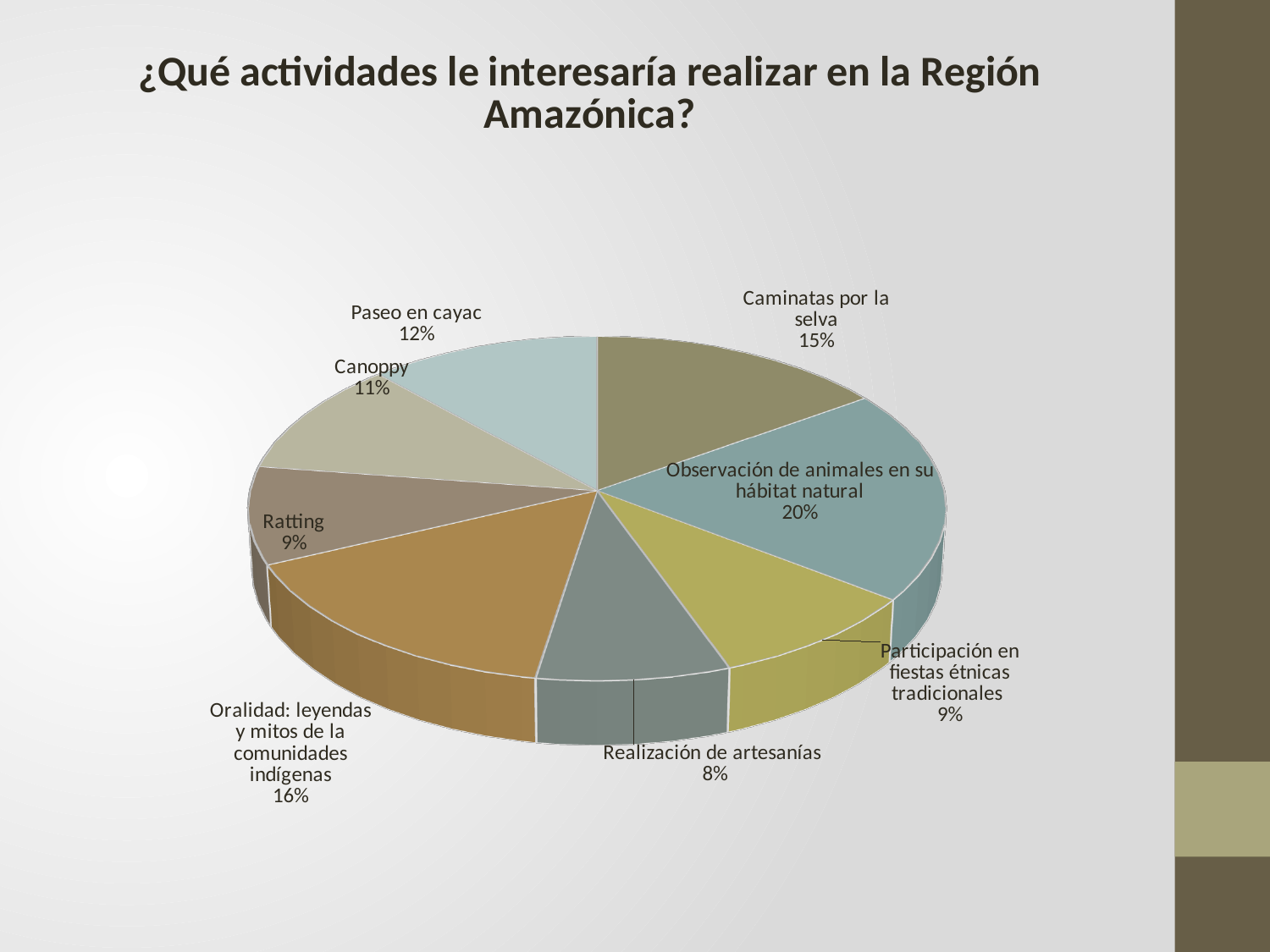
How many slices does the pie chart have? 8 What percentage of respondents are interested in 'Observación de animales en su hábitat natural'? 20% What is the value shown for 'Realización de artesanías'? 8% Which activity has the smallest slice in the pie chart? Realización de artesanías What is the difference between the largest slice and the smallest slice in the pie chart? 12 percentage points What is the title of the slide containing the pie chart? ¿Qué actividades le interesaría realizar en la Región Amazónica? What percentage is shown for 'Canoppy'? 11% Which is larger, the share for 'Paseo en cayac' or the share for 'Ratting'? Paseo en cayac What kind of chart is shown on the slide? Pie chart Which activity has the largest slice in the pie chart? Observación de animales en su hábitat natural What is the difference in percentage points between 'Oralidad: leyendas y mitos de las comunidades indígenas' and 'Caminatas por la selva'? 1 percentage point What share does 'Paseo en cayac' have in the pie chart? 12%